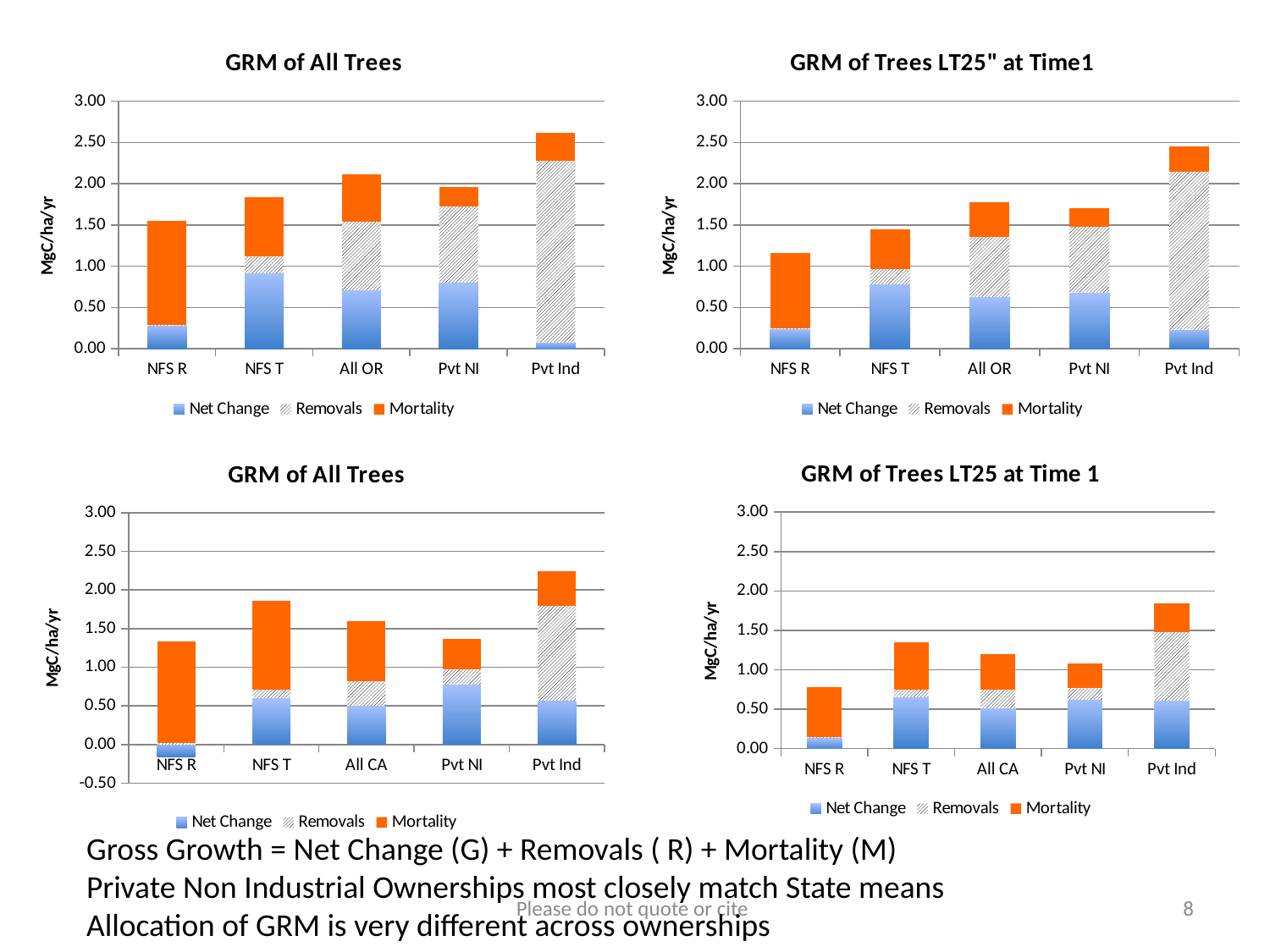
In the top-right chart 'GRM of Trees LT25" at Time1', how many ownership categories are shown on the x axis? 5 In the bottom-left chart 'GRM of All Trees', which category has the lowest Net Change? NFS R In the bottom-right chart 'GRM of Trees LT25 at Time 1', which has the taller stacked bar, NFS R or NFS T? NFS T In the bottom-left chart 'GRM of All Trees', is the Net Change value for NFS R greater or less than 0.00? less In the top-right chart 'GRM of Trees LT25" at Time1', how many series does the legend list? 3 In the top-right chart 'GRM of Trees LT25" at Time1', which category has the shortest stacked bar? NFS R In the top-left chart 'GRM of All Trees', which category has the tallest stacked bar? Pvt Ind What kind of chart is the top-left chart titled 'GRM of All Trees'? Stacked bar chart In the top-right chart 'GRM of Trees LT25" at Time1', is the total stacked bar for NFS R greater or less than 1.00? greater In the top-left chart 'GRM of All Trees', is the total stacked bar for Pvt Ind greater or less than 2.50? greater What is the y-axis label on the top-left chart 'GRM of All Trees'? MgC/ha/yr